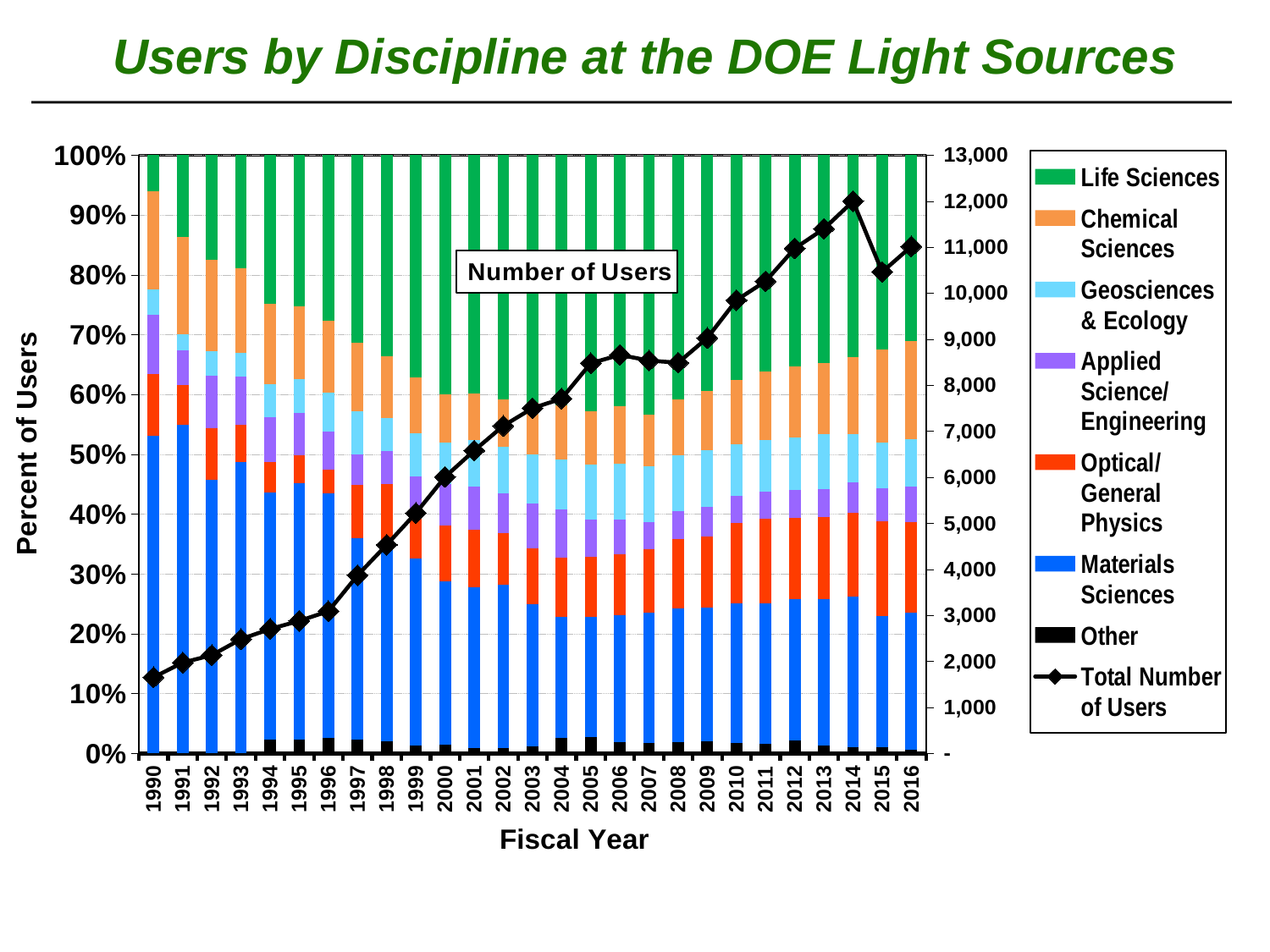
What is the label of the left vertical axis? Percent of Users Is the Materials Sciences share of users in 1990 greater or less than 50%? greater Is the Total Number of Users in 2014 greater or less than 11,000? greater Is the Materials Sciences share of users larger in 1991 or in 2016? 1991 Is the Total Number of Users in 1990 greater or less than 2,000? less Does the Total Number of Users generally rise or fall from 1990 to 2016? rise In which fiscal year is the Total Number of Users lowest? 1990 What kind of chart is shown on the slide? Stacked bar chart with a line How many fiscal years are shown on the x axis? 27 How many entries does the legend list? 8 In which fiscal year is the Total Number of Users highest? 2014